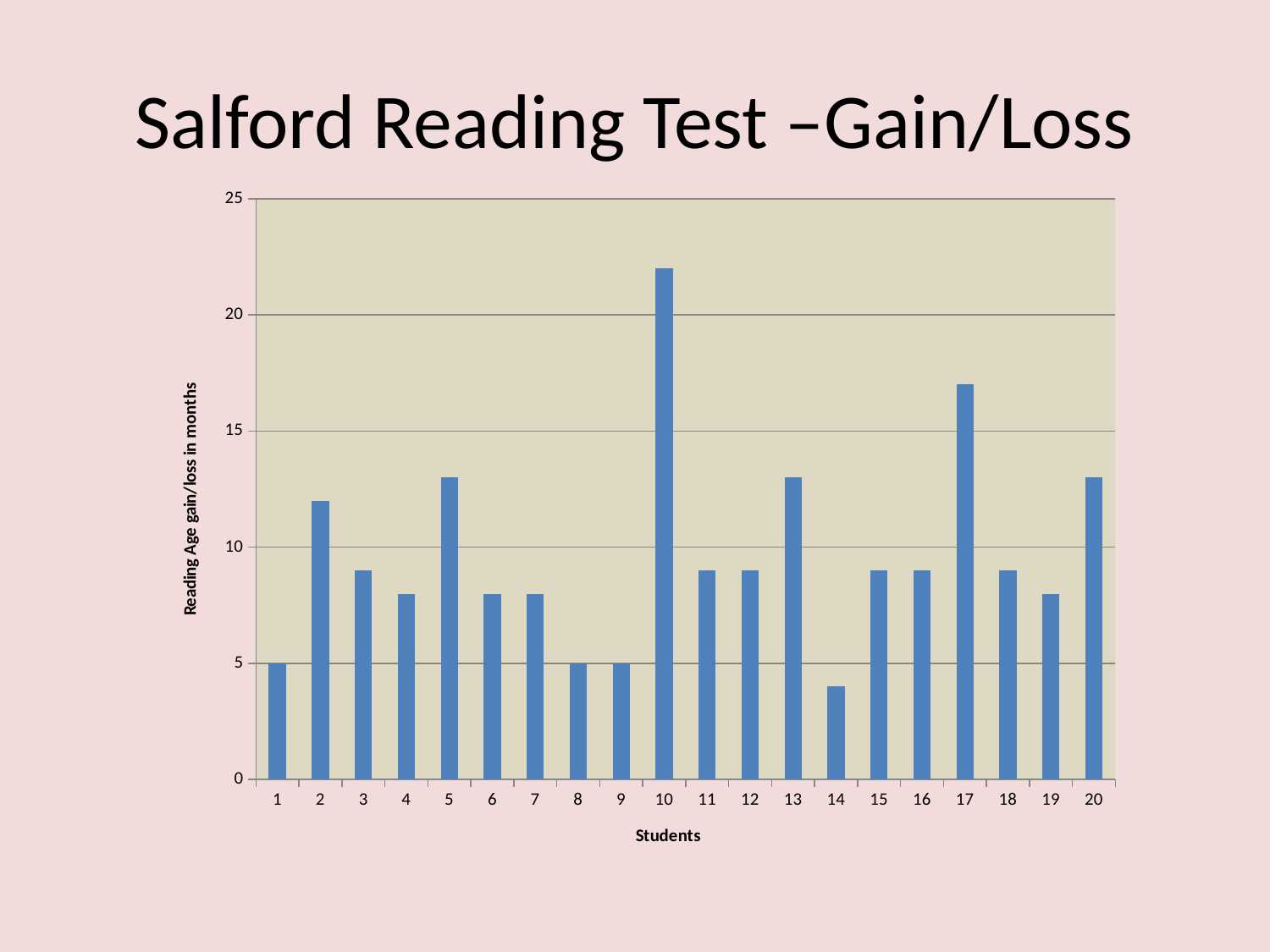
Is the value for student 17 greater or less than 15? greater Is the value for student 3 greater or less than 10? less Which has the larger reading age gain, student 2 or student 3? student 2 What is the reading age gain in months for student 1? 5 Is the value for student 10 greater or less than 20? greater Which student has the highest reading age gain? 10 What kind of chart is shown on the slide? bar chart What is the label on the vertical axis of the chart? Reading Age gain/loss in months How many students are shown on the x axis of the chart? 20 What is the reading age gain in months for student 8? 5 Which student has the lowest reading age gain? 14